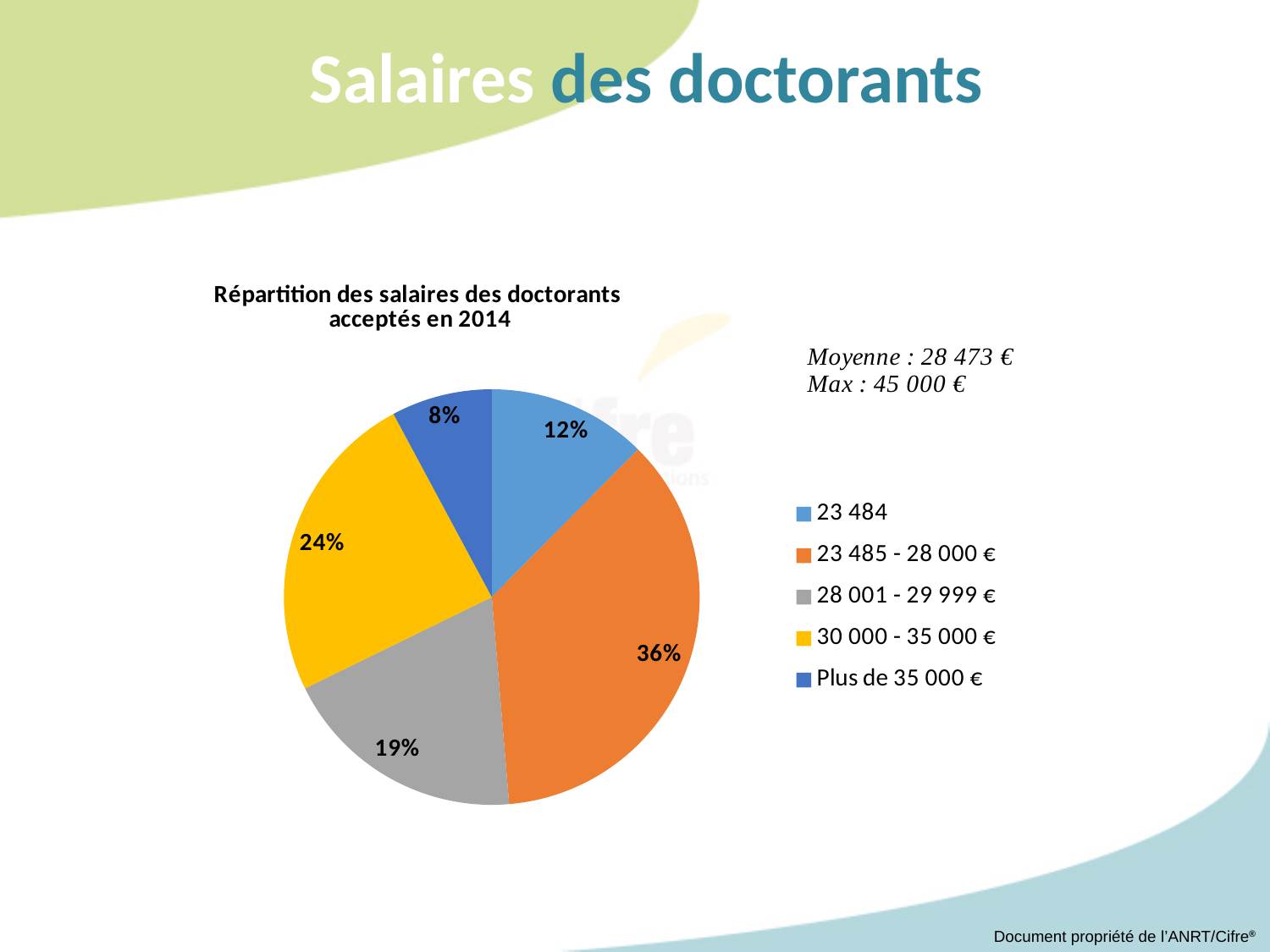
What percentage is shown for the 'Plus de 35 000 €' slice? 8% What percentage is shown for the '28 001 - 29 999 €' slice? 19% Which slice is larger: '23 484' or '28 001 - 29 999 €'? 28 001 - 29 999 € What percentage is shown for the '30 000 - 35 000 €' slice? 24% What kind of chart is shown on the slide? Pie chart Which salary category has the largest share of the pie? 23 485 - 28 000 € What is the difference in percentage points between the '23 485 - 28 000 €' slice and the '30 000 - 35 000 €' slice? 12 What colour is the slice for '30 000 - 35 000 €'? Yellow What is the title of the chart? Répartition des salaires des doctorants acceptés en 2014 How many categories does the pie chart show? 5 Which salary category has the smallest share of the pie? Plus de 35 000 € What share of the pie does the '23 485 - 28 000 €' category represent? 36%